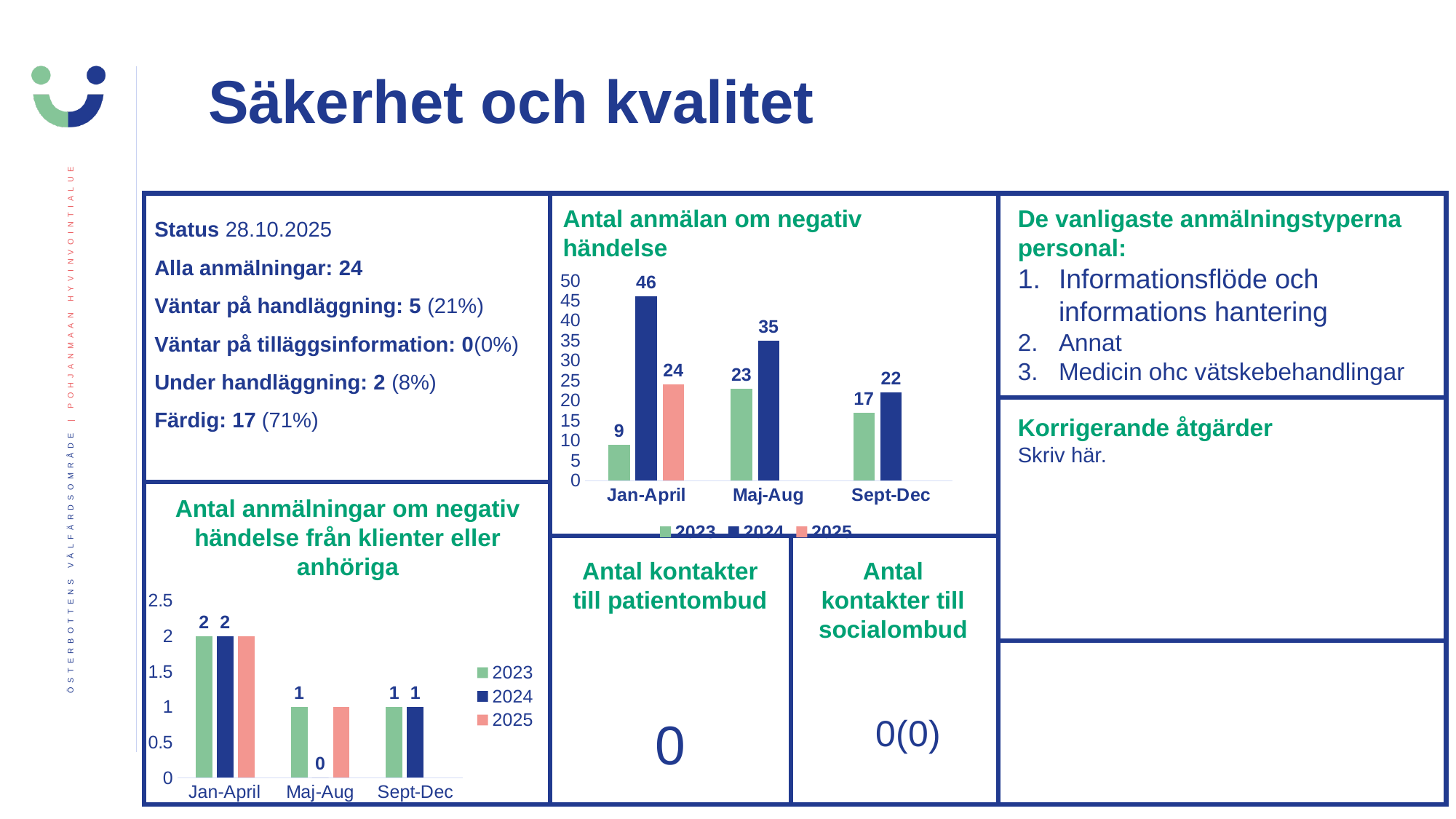
In the chart 'Antal anmälan om negativ händelse', what is the value for 2024 in Jan-April? 46 In the chart 'Antal anmälan om negativ händelse', do the 2024 values rise or fall from Jan-April to Sept-Dec? fall What kind of chart is 'Antal anmälningar om negativ händelse från klienter eller anhöriga'? bar chart In the chart 'Antal anmälningar om negativ händelse från klienter eller anhöriga', what is the value for 2024 in Maj-Aug? 0 In the chart 'Antal anmälan om negativ händelse', which is larger in Maj-Aug: the 2023 value or the 2024 value? 2024 In the chart 'Antal anmälan om negativ händelse', what is the value for 2025 in Jan-April? 24 How many periods are shown on the x axis of the chart 'Antal anmälningar om negativ händelse från klienter eller anhöriga'? 3 In the chart 'Antal anmälan om negativ händelse', what is the difference between the 2024 and 2023 values in Sept-Dec? 5 In the chart 'Antal anmälan om negativ händelse', which period has the lowest value for the 2023 series? Jan-April In the chart 'Antal anmälan om negativ händelse', which period has the highest value for the 2024 series? Jan-April In the chart 'Antal anmälan om negativ händelse', what is the value for 2023 in Maj-Aug? 23 How many series does the legend of the chart 'Antal anmälan om negativ händelse' list? 3